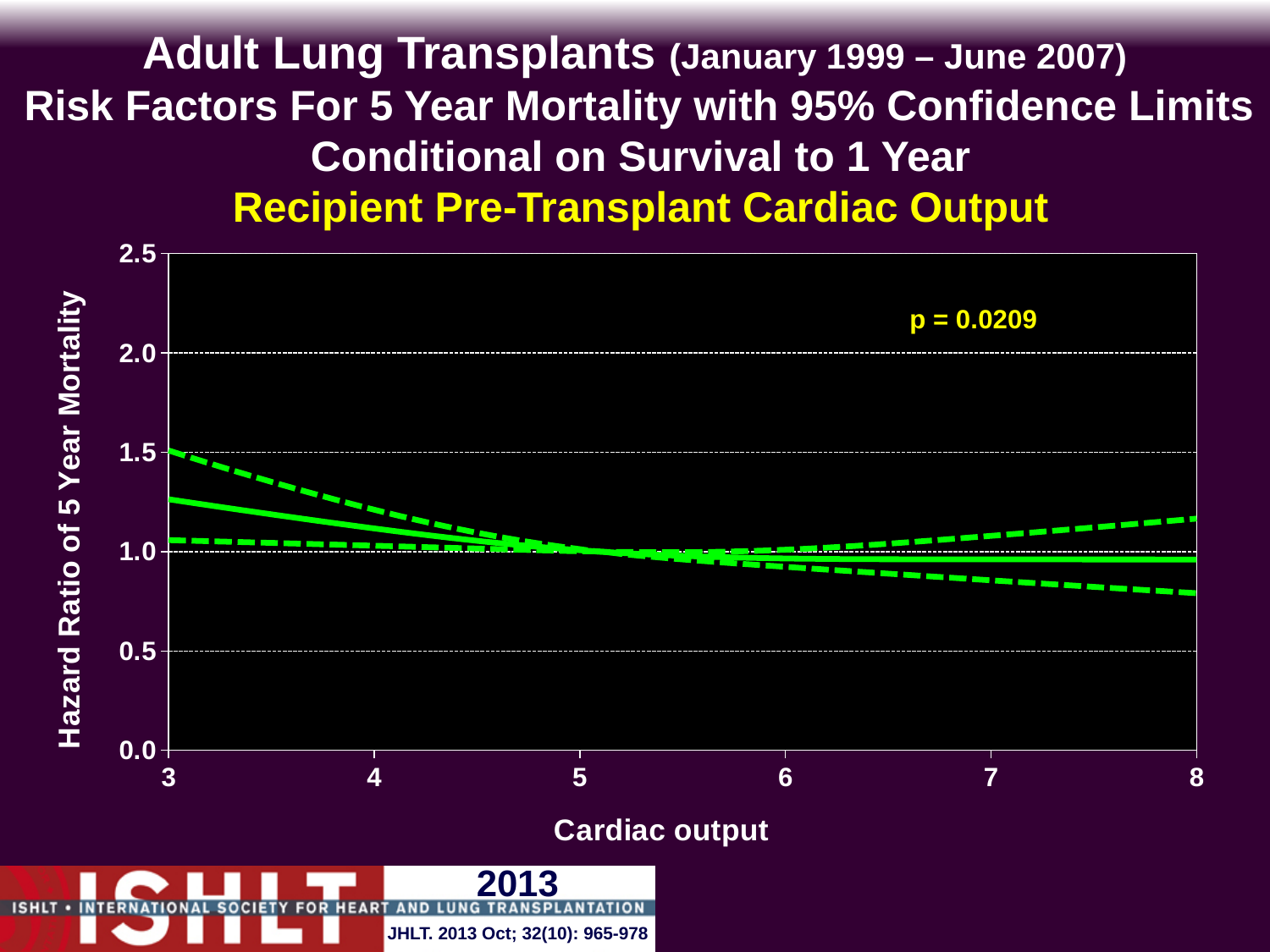
What is the label of the x axis? Cardiac output What kind of chart is shown on the slide? line chart Is the solid hazard ratio line at a cardiac output of 3 greater or less than 1.5? less Is the solid hazard ratio line at a cardiac output of 3 greater or less than 1.0? greater How many tick labels are shown on the x axis? 6 What is the p-value printed on the chart? p = 0.0209 Does the solid hazard ratio line rise or fall as cardiac output increases from 3 to 8? fall What is the highest value labelled on the y axis? 2.5 Is the upper dashed confidence limit at a cardiac output of 8 greater or less than 1.0? greater Is the solid hazard ratio line higher at a cardiac output of 3 or at a cardiac output of 8? 3 How many lines are plotted on the chart? 3